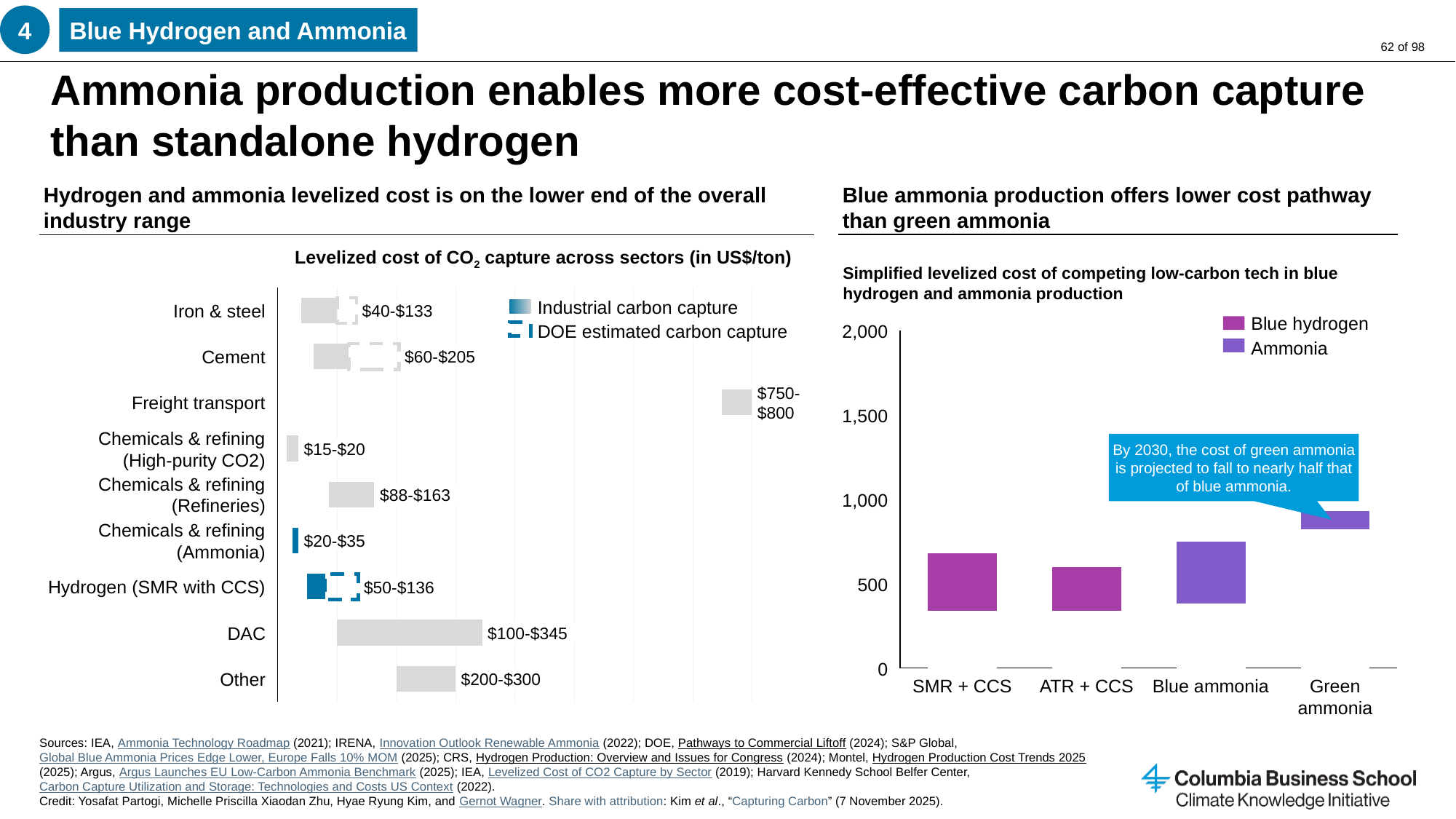
On the right chart, which category has the highest cost? Green ammonia On the left chart, 'Levelized cost of CO2 capture across sectors', what kind of chart is shown? Bar chart On the left chart, what is the levelized cost range shown for Freight transport? $750-$800 On the left chart, what is the levelized cost range shown for DAC? $100-$345 On the right chart, is the value for Green ammonia greater or less than 1,000? less On the left chart, which sector has the lowest levelized cost of CO2 capture? Chemicals & refining (High-purity CO2) On the left chart, which sector has the highest levelized cost of CO2 capture? Freight transport On the left chart, what is the levelized cost range shown for Chemicals & refining (Ammonia)? $20-$35 On the left chart, how many entries does the legend list? 2 On the left chart, what is the levelized cost range shown for Hydrogen (SMR with CCS)? $50-$136 On the left chart, how many sectors are listed on the vertical axis? 9 On the right chart, 'Simplified levelized cost of competing low-carbon tech', how many categories are shown on the x axis? 4